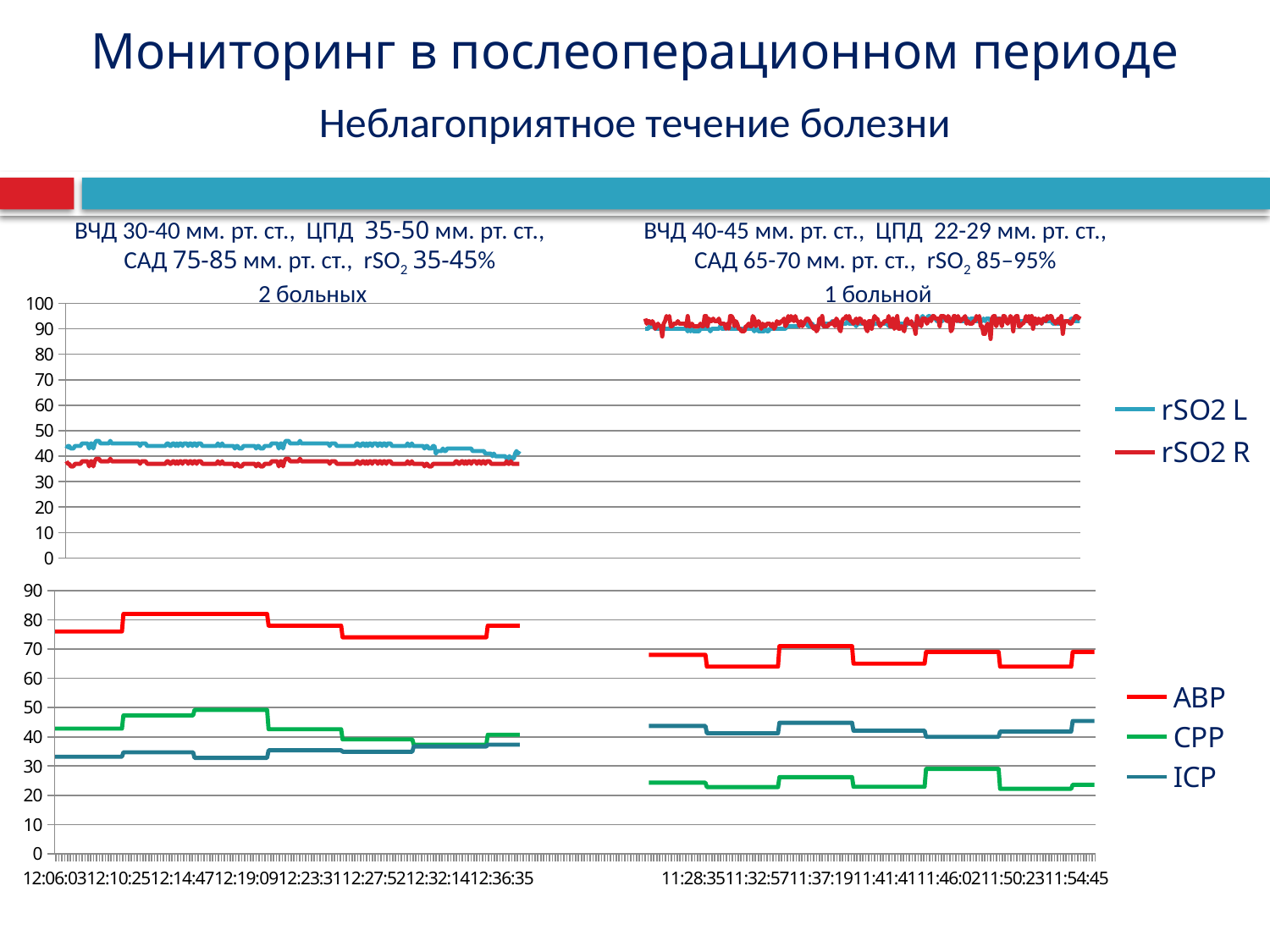
In the bottom chart, which series is drawn in green? CPP How many series does the legend of the top chart list? 2 In the bottom chart, is the value of ABP in the left-hand segment (2 больных) greater or less than 70? greater In the top chart, is the value of rSO2 R in the left-hand segment (2 больных) greater or less than 40? less In the bottom chart, in the right-hand segment (1 больной), which series is higher: CPP or ICP? ICP What kind of chart is the top chart on the slide? line chart How many series does the legend of the bottom chart list? 3 In the top chart, in the left-hand segment (2 больных), which series is higher: rSO2 L or rSO2 R? rSO2 L In the top chart, which series is drawn in red? rSO2 R In the top chart, is the value of rSO2 L in the right-hand segment (1 больной) greater or less than 80? greater